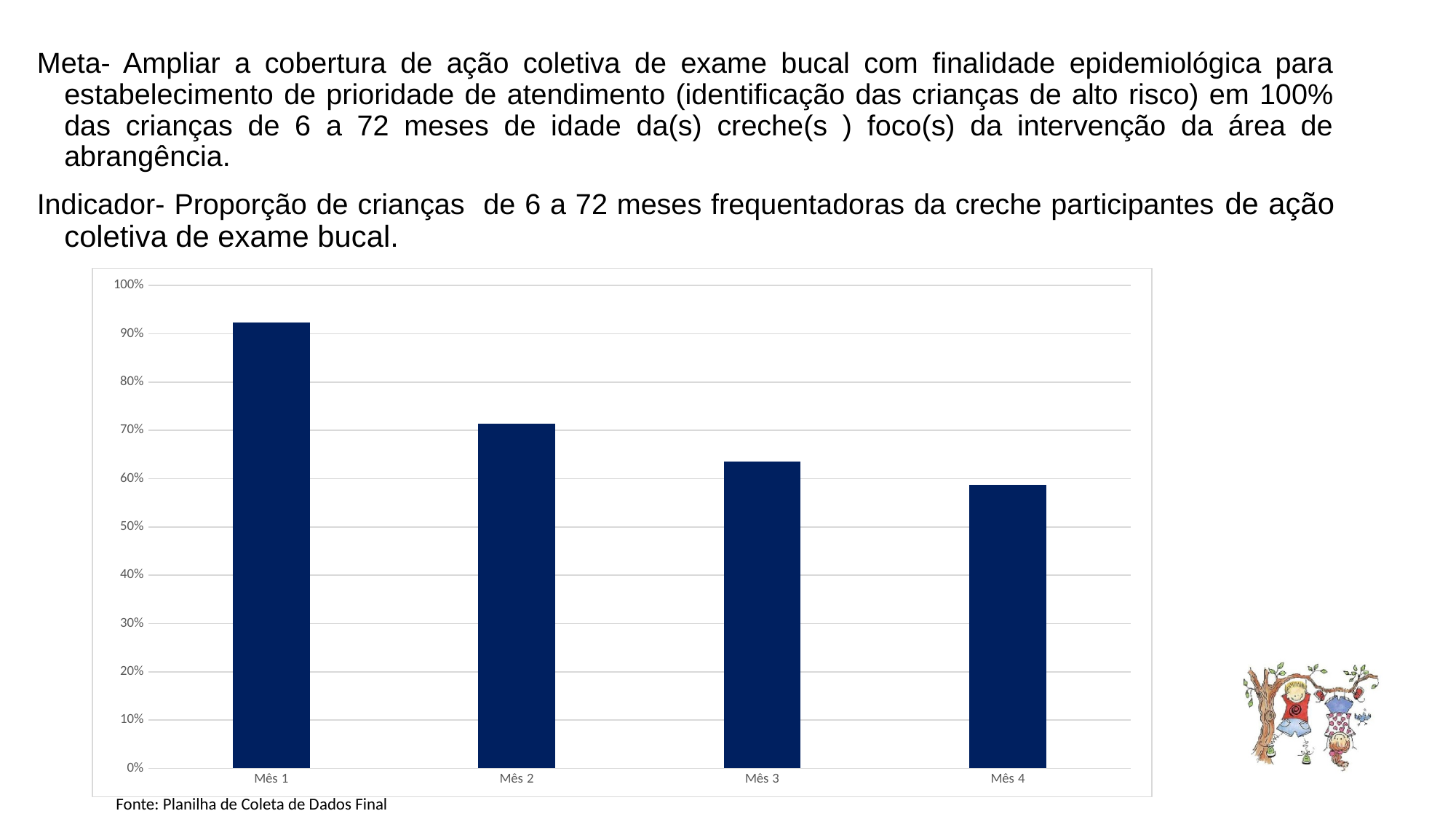
Which is larger, the value for Mês 2 or the value for Mês 3? Mês 2 What kind of chart is shown on the slide? bar chart Do the values rise or fall from Mês 1 to Mês 4? fall Is the value for Mês 2 greater or less than 70%? greater What is the highest value shown on the vertical axis of the chart? 100% What is the source cited below the chart? Planilha de Coleta de Dados Final Is the value for Mês 4 greater or less than 60%? less Is the value for Mês 3 greater or less than 70%? less Which month has the lowest value on the chart? Mês 4 How many categories (months) are plotted on the chart? 4 Which month has the highest value on the chart? Mês 1